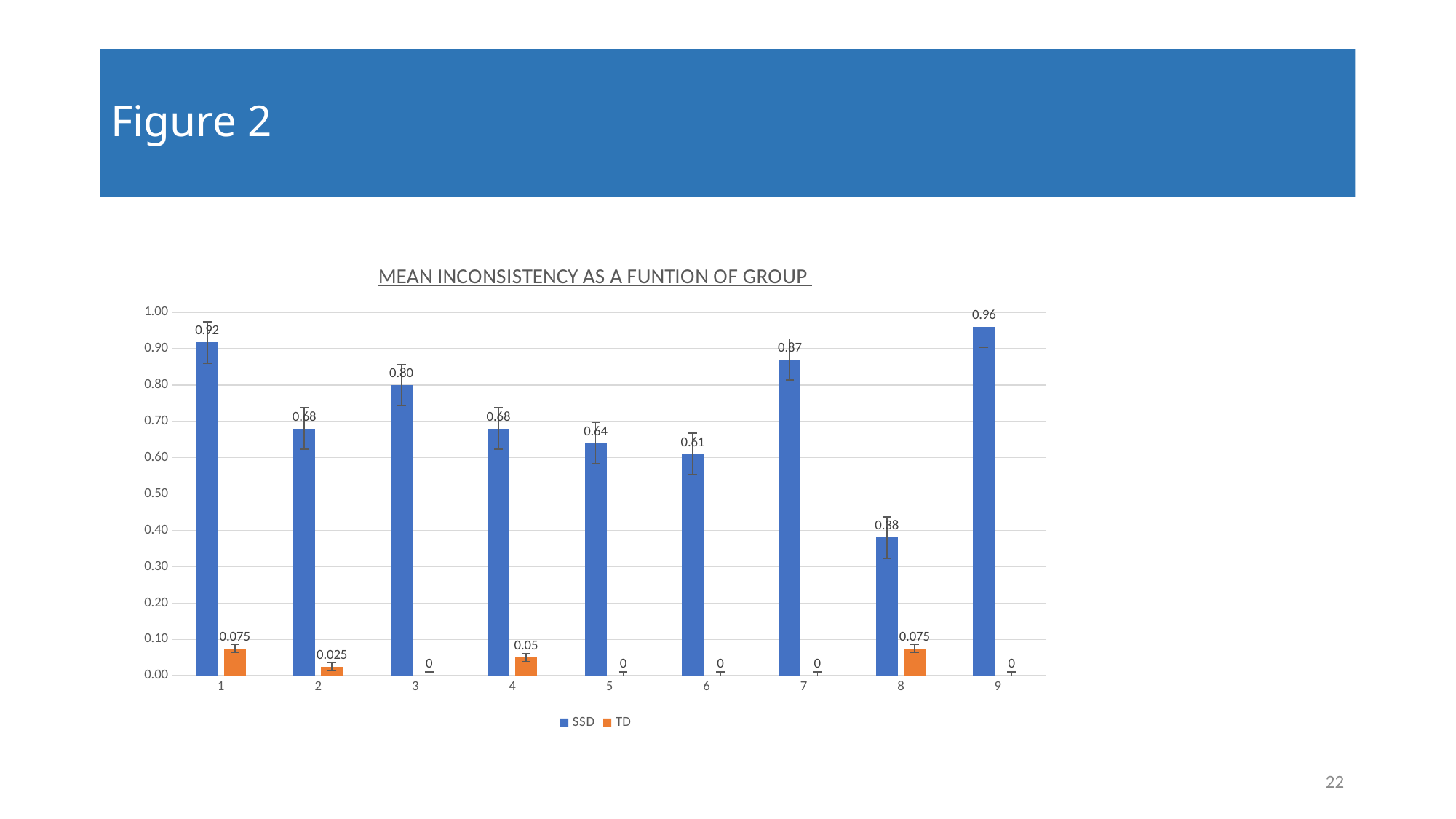
What is the TD value for group 4? 0.05 Which is larger, the SSD value for group 3 or the SSD value for group 7? group 7 What kind of chart is shown on the slide? bar chart What is the SSD value for group 8? 0.38 How many groups have a TD value of 0? 5 Which group has the highest SSD value? 9 What is the title of the chart? MEAN INCONSISTENCY AS A FUNTION OF GROUP What is the SSD value for group 1? 0.92 How many groups are shown on the x axis? 9 How many series does the legend list? 2 Which group has the lowest SSD value? 8 What is the difference between the SSD values for group 9 and group 8? 0.58